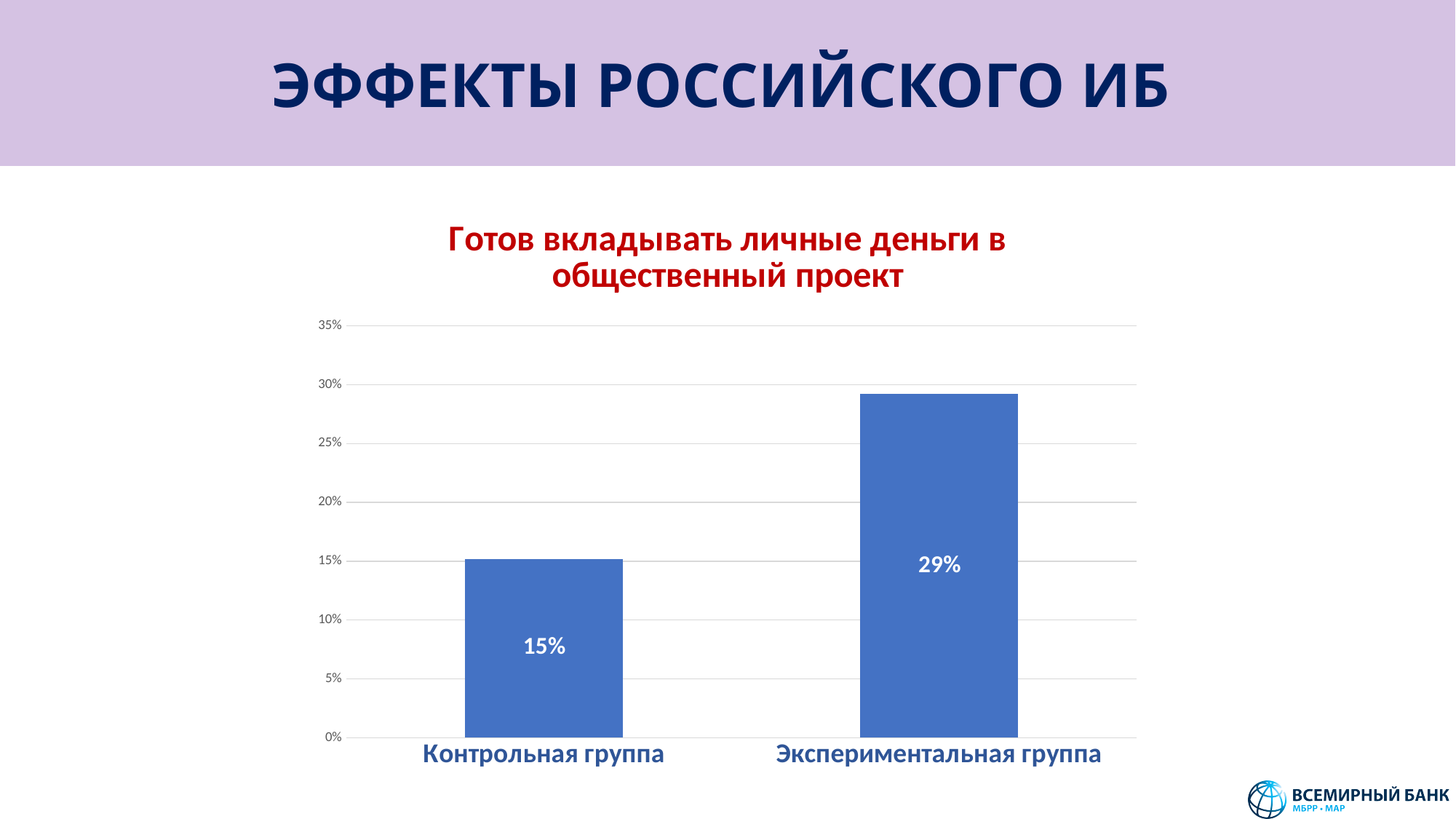
What is the highest value shown on the vertical axis? 35% What is the value for Контрольная группа? 15% Is the value for Контрольная группа greater or less than 20%? less What is the title of the chart? Готов вкладывать личные деньги в общественный проект How many categories are shown in the chart? 2 Which is larger, the value for Контрольная группа or for Экспериментальная группа? Экспериментальная группа Which group has the lowest value? Контрольная группа What kind of chart is shown on the slide? Bar chart Which group has the highest value? Экспериментальная группа Is the value for Экспериментальная группа greater or less than 25%? greater What is the value for Экспериментальная группа? 29% What is the difference between the values for Экспериментальная группа and Контрольная группа? 14%